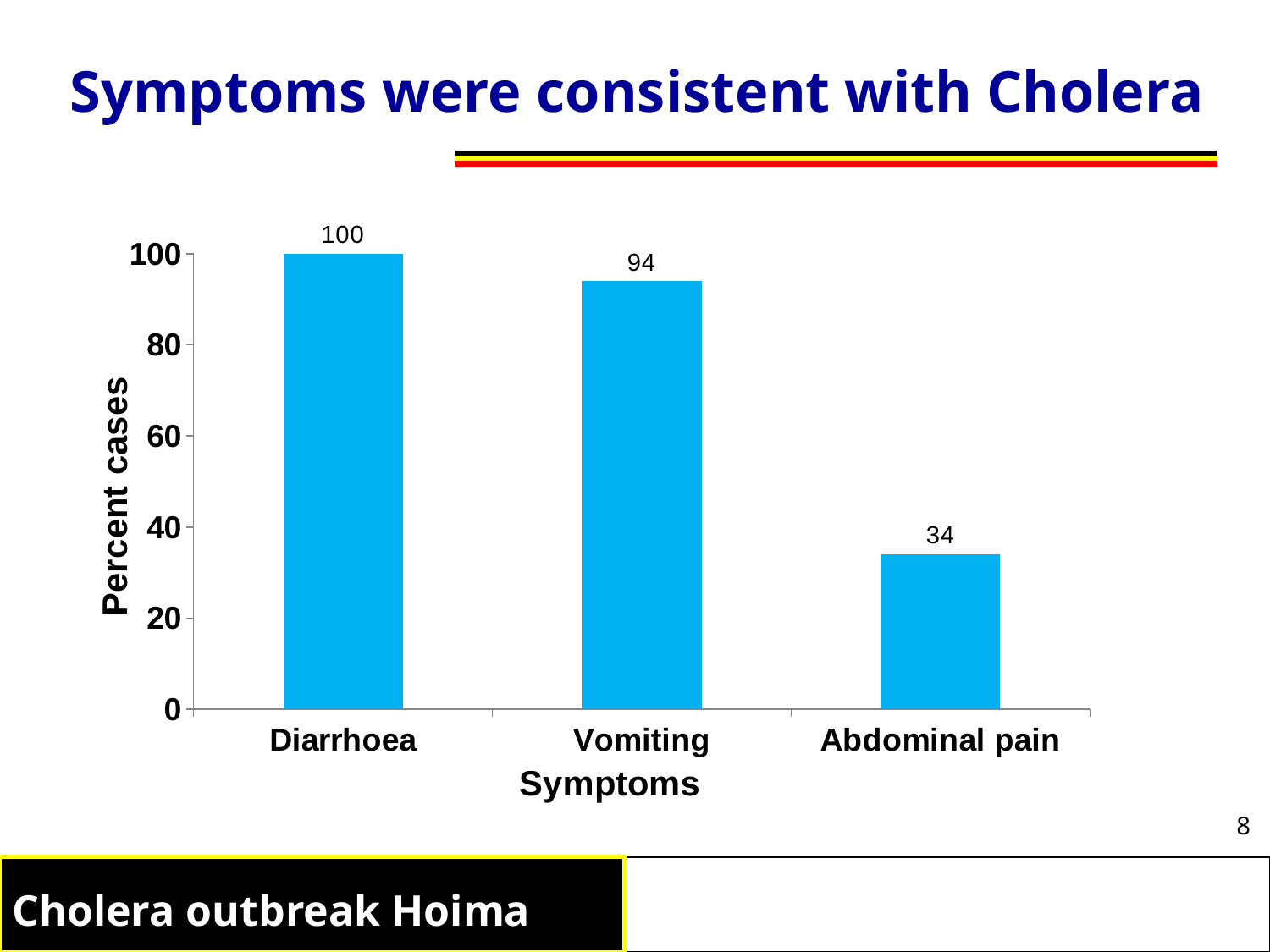
Is the value for Abdominal pain greater or less than 40? less Which has a higher percent of cases, Vomiting or Abdominal pain? Vomiting Which symptom has the lowest percent of cases? Abdominal pain What is the difference in percent cases between Vomiting and Abdominal pain? 60 What is the percent of cases with Diarrhoea? 100 Which symptom has the highest percent of cases? Diarrhoea What kind of chart is shown on the slide? Bar chart What is the percent of cases with Abdominal pain? 34 What is the label of the y axis? Percent cases How many symptoms are shown on the chart? 3 What is the percent of cases with Vomiting? 94 What is the difference in percent cases between Diarrhoea and Abdominal pain? 66